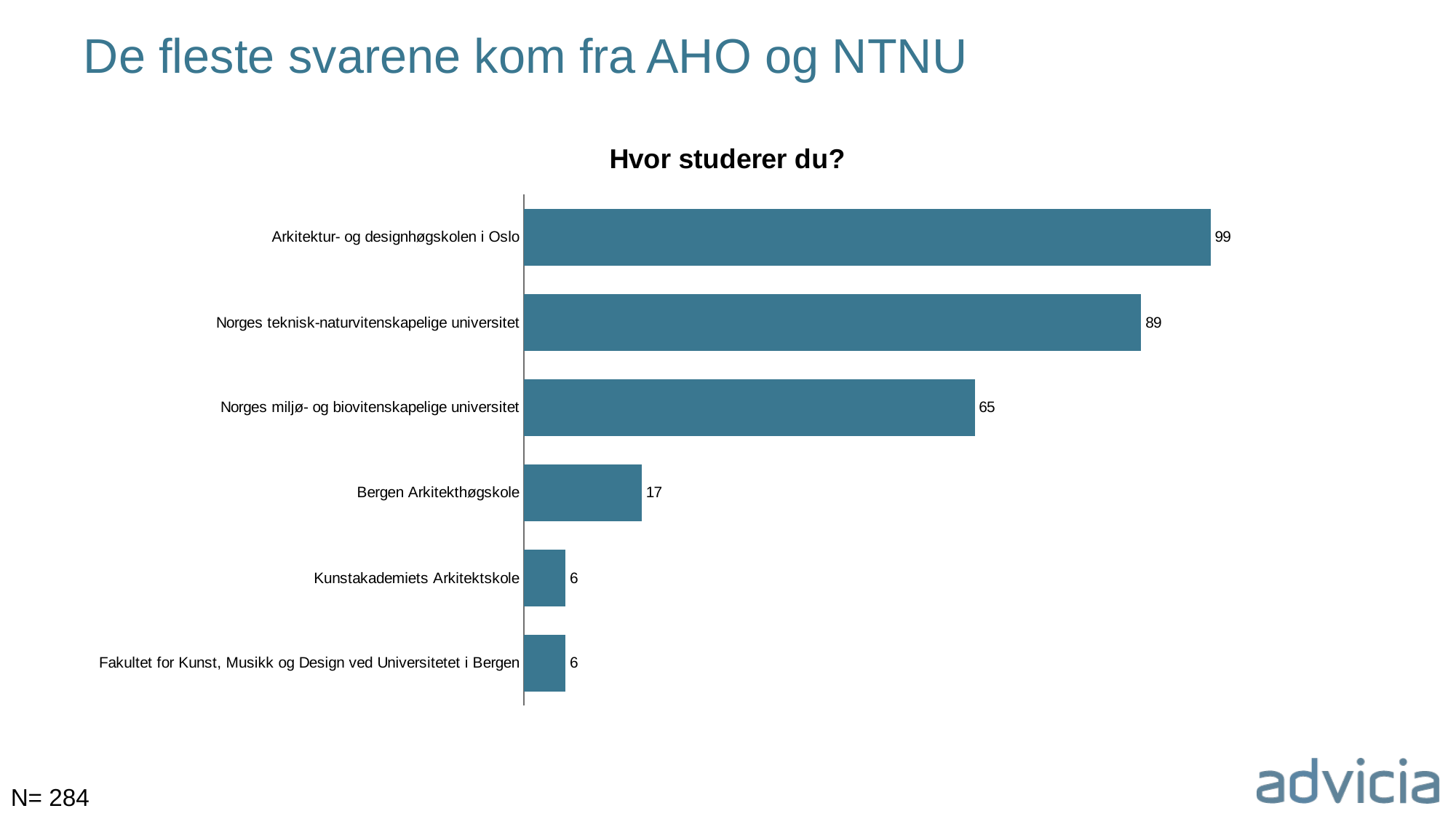
What is the value for Arkitektur- og designhøgskolen i Oslo? 99 What is the title of the chart? Hvor studerer du? What is the value for Kunstakademiets Arkitektskole? 6 What is the value for Norges teknisk-naturvitenskapelige universitet? 89 What is the value for Bergen Arkitekthøgskole? 17 What kind of chart is shown on the slide? Bar chart What is the value for Norges miljø- og biovitenskapelige universitet? 65 How many categories are shown in the chart? 6 Which category has the highest value? Arkitektur- og designhøgskolen i Oslo What is the difference between the values for Arkitektur- og designhøgskolen i Oslo and Norges teknisk-naturvitenskapelige universitet? 10 Which is larger, the value for Norges miljø- og biovitenskapelige universitet or the value for Bergen Arkitekthøgskole? Norges miljø- og biovitenskapelige universitet What is the difference between the values for Norges miljø- og biovitenskapelige universitet and Bergen Arkitekthøgskole? 48